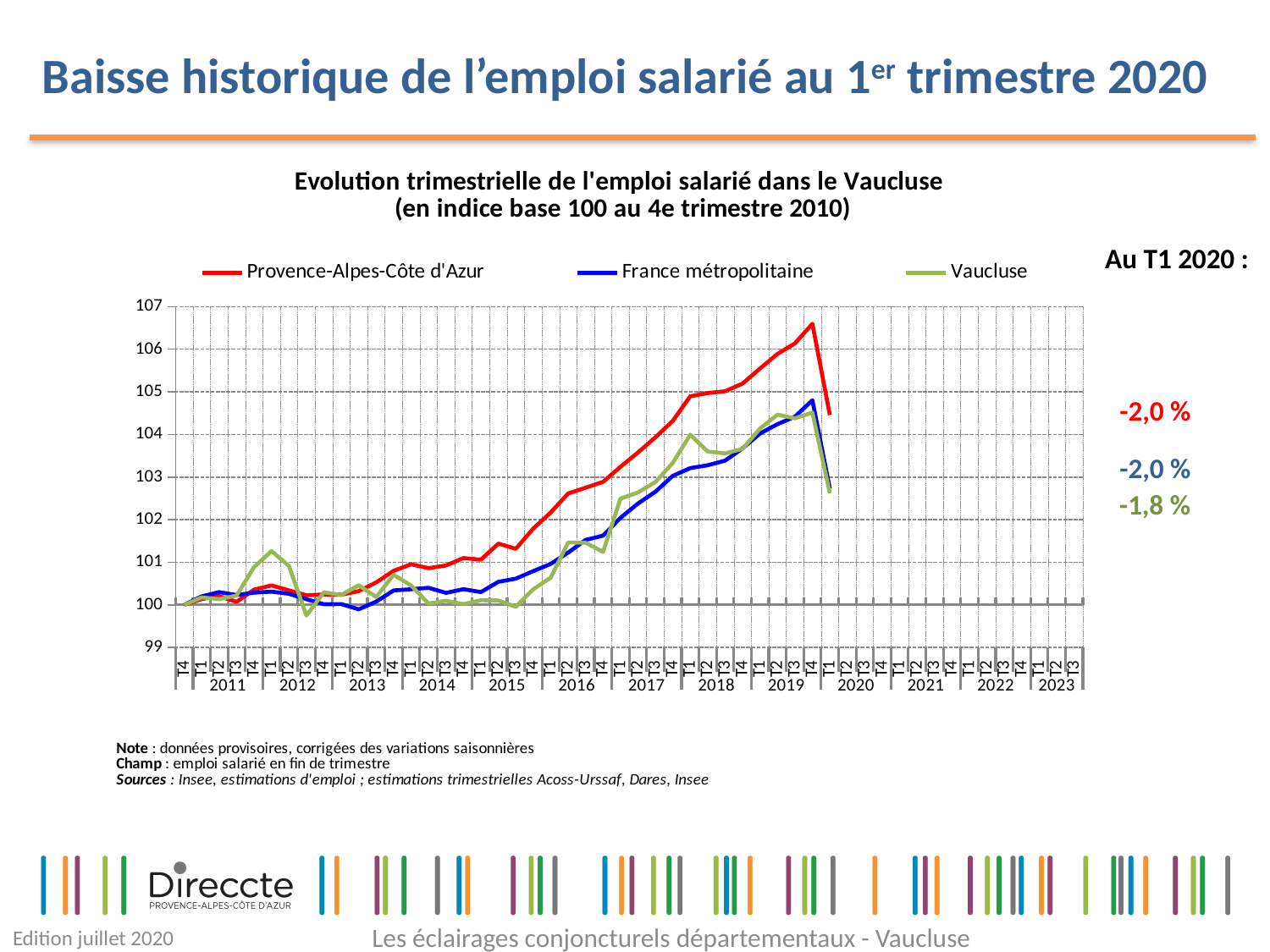
Is the value for France métropolitaine at T4 2019 greater or less than 105? less According to the annotation on the right, what is the change for Vaucluse at T1 2020? -1,8 % Is the value for Provence-Alpes-Côte d'Azur at T4 2019 greater or less than 106? greater Is the value for Vaucluse at T1 2020 greater or less than 103? less At T4 2019, which is larger: Provence-Alpes-Côte d'Azur or France métropolitaine? Provence-Alpes-Côte d'Azur How many series does the legend list? 3 What kind of chart is shown on the slide? line chart Which series has the highest value at T4 2019? Provence-Alpes-Côte d'Azur Does the Provence-Alpes-Côte d'Azur series rise or fall between T1 2016 and T4 2019? rise Which series are listed in the legend? Provence-Alpes-Côte d'Azur, France métropolitaine, Vaucluse What is the index value of all three series at T4 2010? 100 What is the title of the chart? Evolution trimestrielle de l'emploi salarié dans le Vaucluse (en indice base 100 au 4e trimestre 2010)